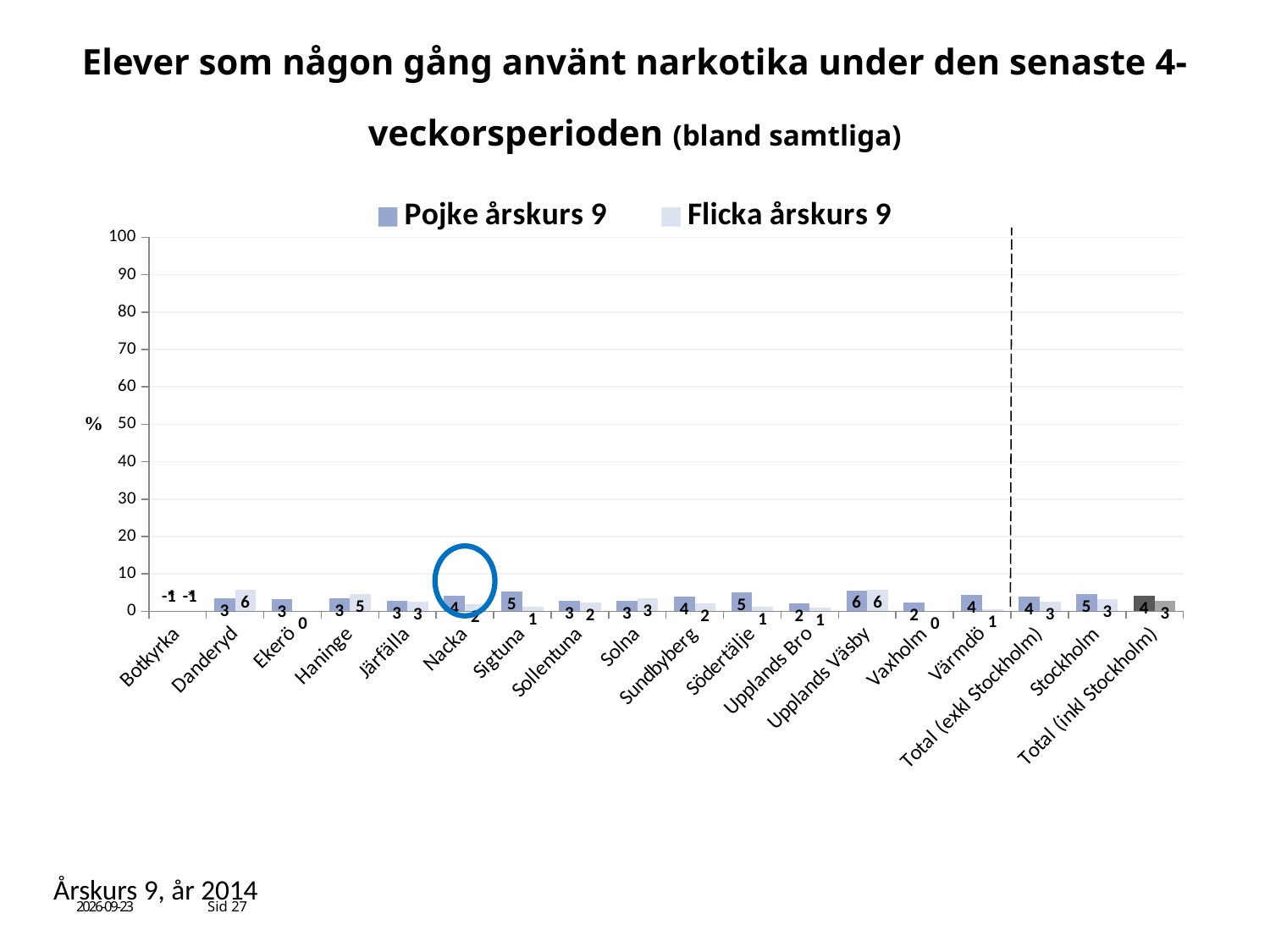
What kind of chart is shown on the slide? bar chart How many series does the legend list? 2 What is the value for Flicka årskurs 9 for Total (inkl Stockholm)? 3 In Sigtuna, which series has the larger value, Pojke årskurs 9 or Flicka årskurs 9? Pojke årskurs 9 Is the value for Pojke årskurs 9 in Stockholm greater or less than 10? less Which category has the highest value for Pojke årskurs 9? Upplands Väsby How many categories are shown on the x axis? 18 What is the value for Flicka årskurs 9 in Danderyd? 6 What is the value for Pojke årskurs 9 in Stockholm? 5 What is the value for Pojke årskurs 9 in Nacka? 4 In Danderyd, how much higher is the Flicka årskurs 9 value than the Pojke årskurs 9 value? 3 What is the value for Flicka årskurs 9 in Sigtuna? 1